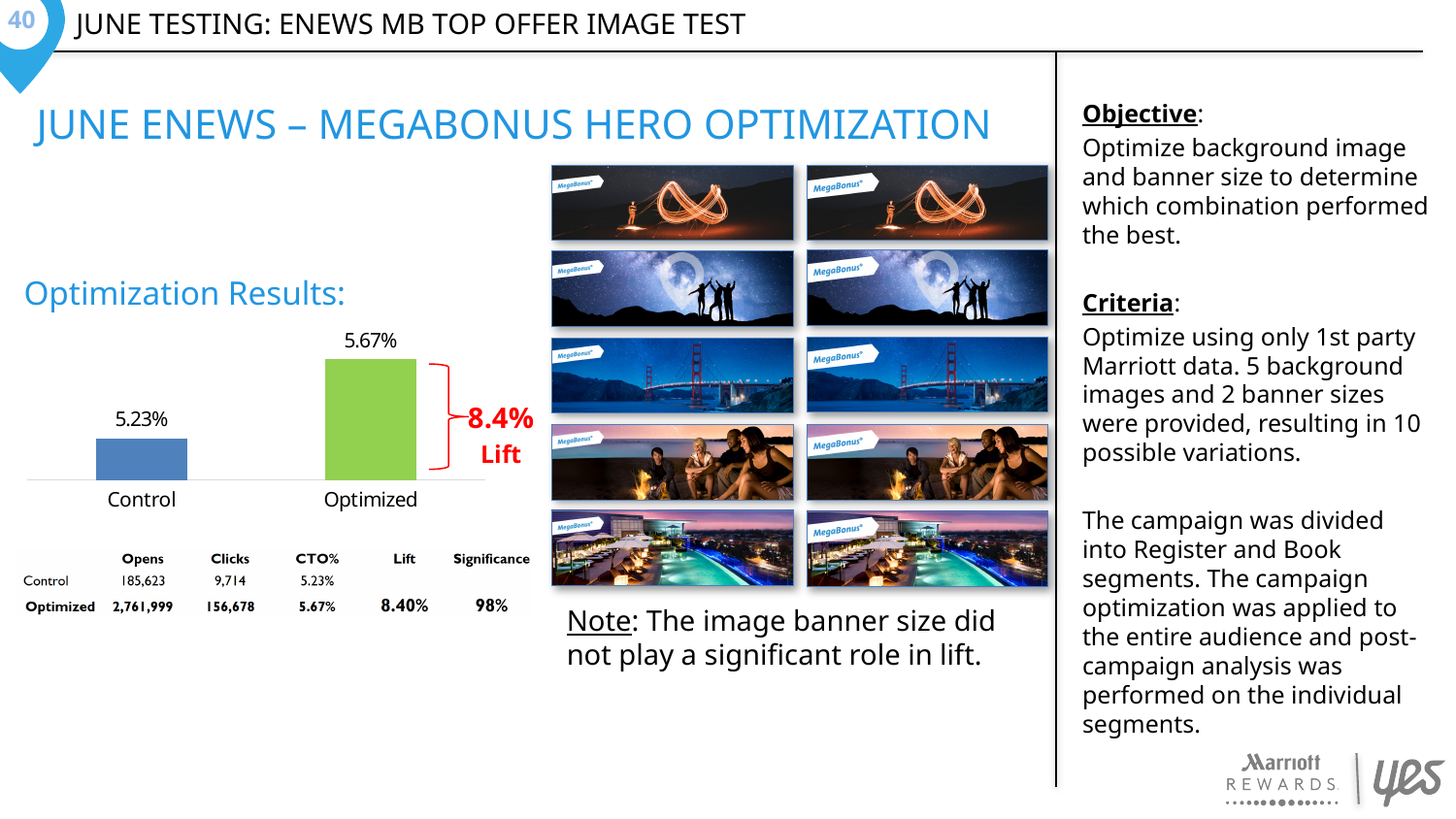
What kind of chart is used to show the Optimization Results? bar chart What lift percentage is annotated next to the Optimized bar in the Optimization Results chart? 8.4% How many categories are shown in the Optimization Results chart? 2 What colour is the Optimized bar in the Optimization Results chart? green Is the value for Control larger or smaller than the value for Optimized in the Optimization Results chart? smaller Do the values rise or fall from Control to Optimized in the Optimization Results chart? rise What is the difference between the Optimized and Control values in the Optimization Results chart? 0.44% Which category has the higher value in the Optimization Results chart? Optimized Which category has the lower value in the Optimization Results chart? Control What is the value shown for Control in the Optimization Results chart? 5.23% What is the value shown for Optimized in the Optimization Results chart? 5.67%